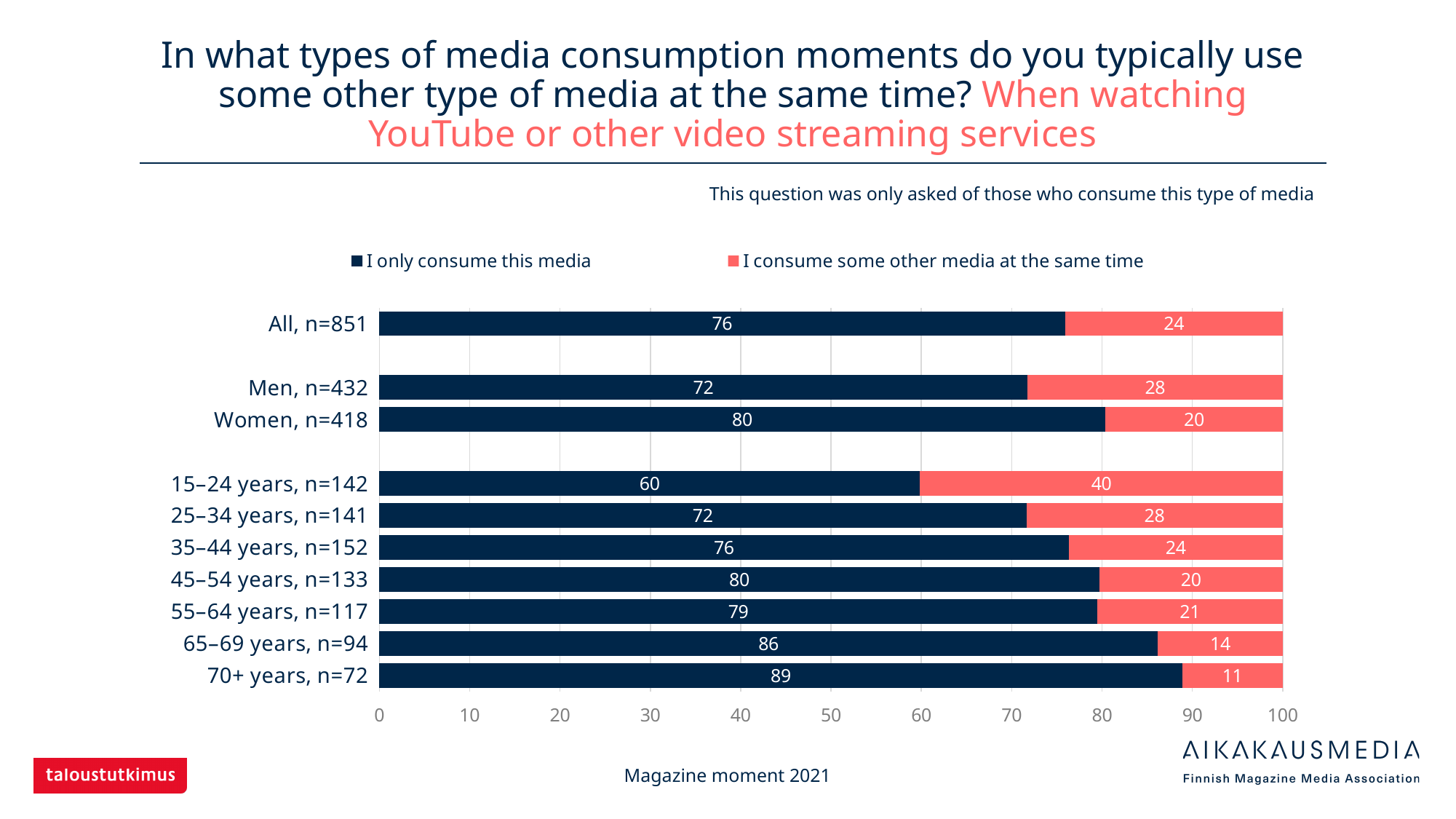
How many categories are shown on the y axis? 10 How many series does the legend list? 2 Which category has the highest value for "I consume some other media at the same time"? 15–24 years, n=142 What is the total of the stacked bar for 45–54 years, n=133? 100 Which has a larger "I consume some other media at the same time" value: 65–69 years, n=94 or 55–64 years, n=117? 55–64 years, n=117 What is the value of "I consume some other media at the same time" for 15–24 years, n=142? 40 Which category has the lowest value for "I only consume this media"? 15–24 years, n=142 What is the value of "I only consume this media" for All, n=851? 76 What is the difference between the "I only consume this media" values for Women, n=418 and Men, n=432? 8 What colour represents "I consume some other media at the same time" in the legend? Red (coral) What is the value of "I only consume this media" for 70+ years, n=72? 89 What kind of chart is shown on the slide? Stacked bar chart